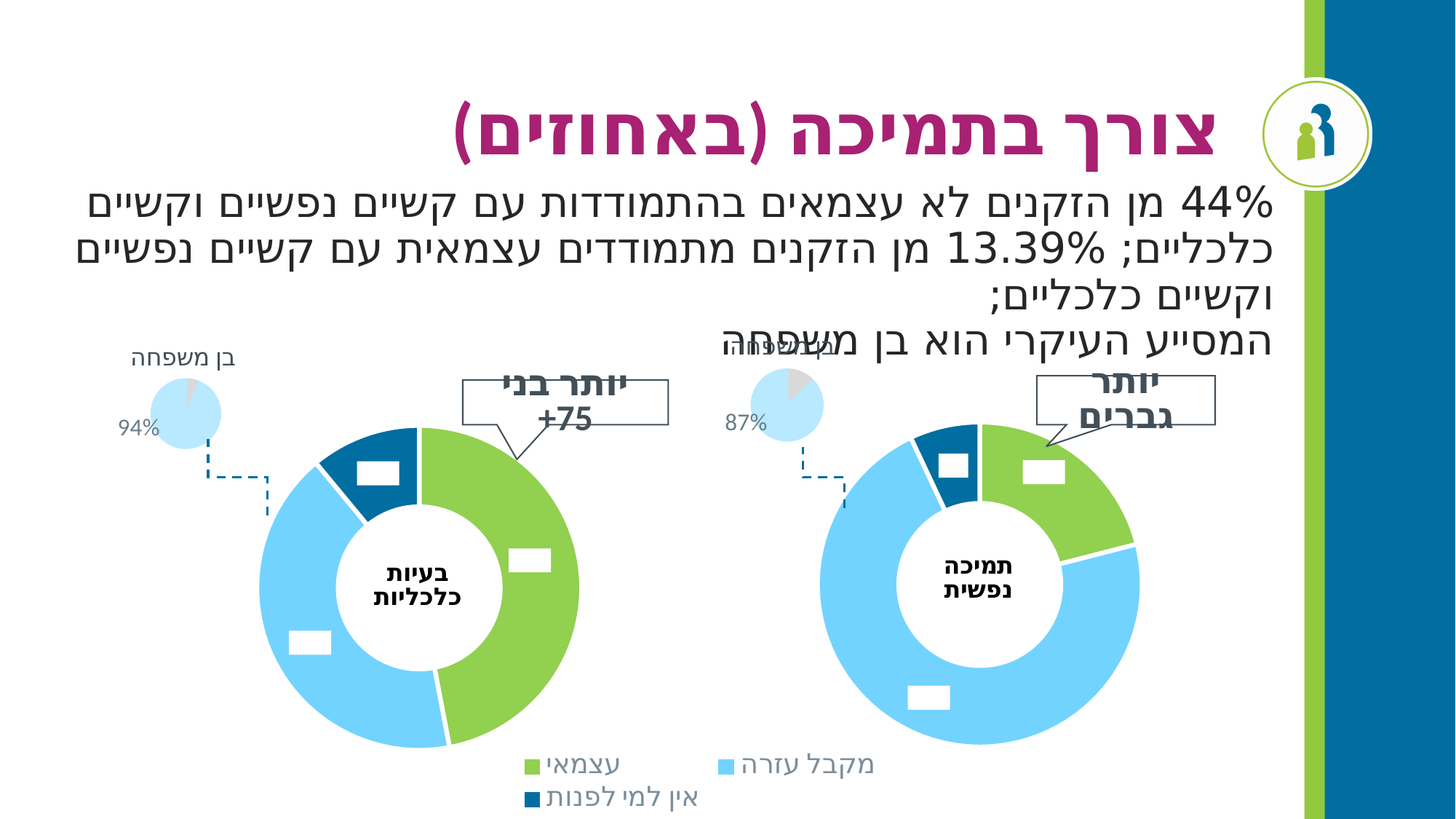
Which small בן משפחה pie shows the larger percentage: the one next to בעיות כלכליות or the one next to תמיכה נפשית? The one next to בעיות כלכליות In the chart labelled תמיכה נפשית, which category has the largest share? מקבל עזרה What percentage is shown in the small pie chart labelled בן משפחה next to the תמיכה נפשית chart? 87% In the chart labelled תמיכה נפשית, which category has the smallest share? אין למי לפנות In the chart labelled תמיכה נפשית, which is larger: the share for עצמאי or the share for אין למי לפנות? עצמאי How many categories does the legend list for the donut charts? 3 What kind of chart is the chart labelled בעיות כלכליות? Donut (pie) chart In the chart labelled תמיכה נפשית, which is larger: the share for עצמאי or the share for מקבל עזרה? מקבל עזרה What is the difference between the two small בן משפחה pie percentages (94% and 87%)? 7% Which legend category is shown in green in the donut charts? עצמאי What percentage is shown in the small pie chart labelled בן משפחה next to the בעיות כלכליות chart? 94% In the chart labelled בעיות כלכליות, which category has the smallest share? אין למי לפנות